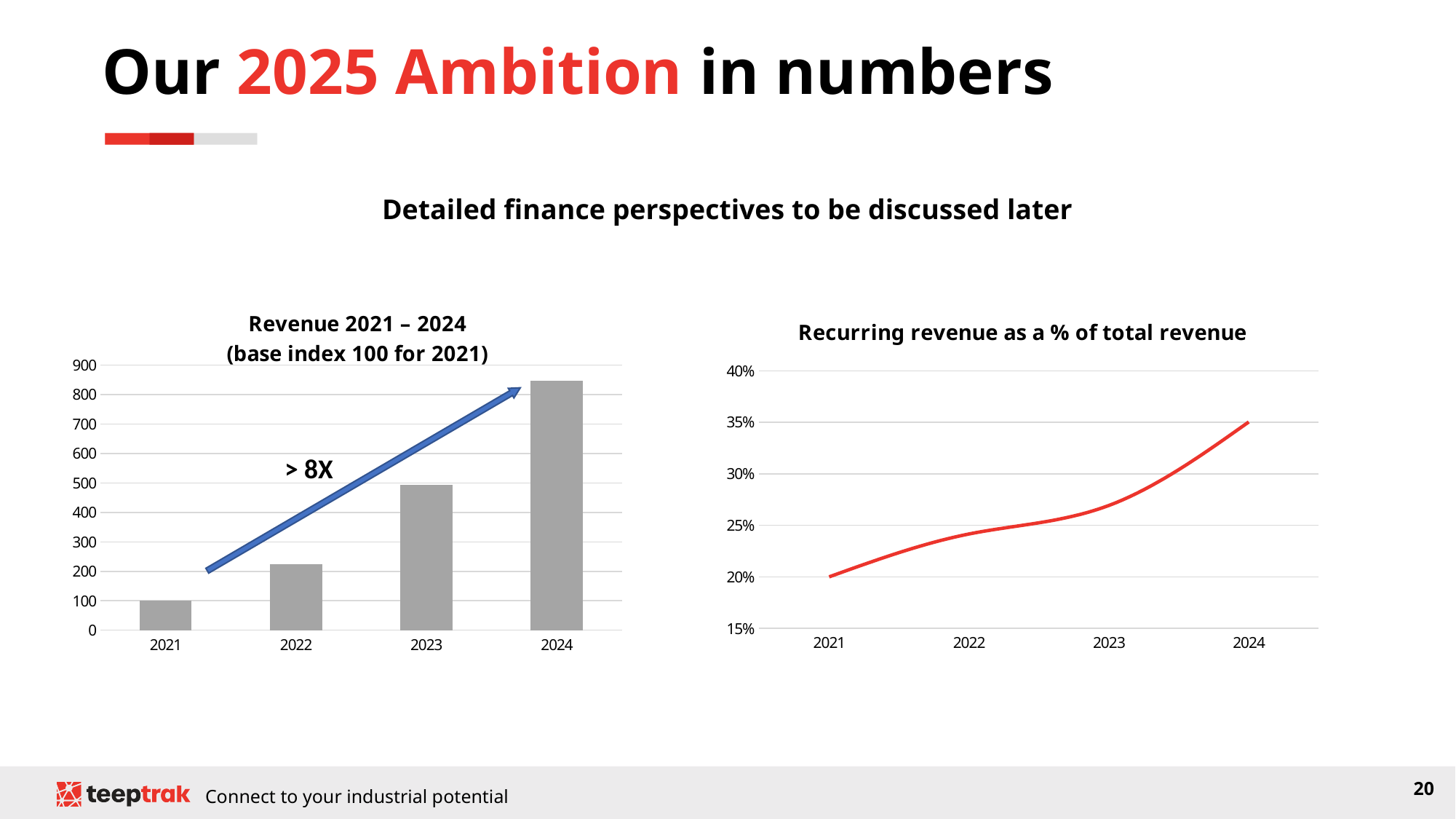
On the Revenue 2021 – 2024 chart, how many years are shown? 4 On the Recurring revenue as a % of total revenue chart, do the values rise or fall from 2021 to 2024? rise On the Recurring revenue as a % of total revenue chart, what is the value for 2024? 35% On the Revenue 2021 – 2024 chart, which year has the lowest revenue? 2021 On the Revenue 2021 – 2024 chart, is the value for 2024 greater or less than 800? greater On the Revenue 2021 – 2024 chart, which year has the highest revenue? 2024 On the Revenue 2021 – 2024 chart, what is the value for 2021? 100 On the Revenue 2021 – 2024 chart, is the value for 2022 greater or less than 200? greater On the Recurring revenue as a % of total revenue chart, what is the value for 2021? 20% What kind of chart is the Revenue 2021 – 2024 chart? bar chart On the Recurring revenue as a % of total revenue chart, is the value for 2022 greater or less than 25%? less